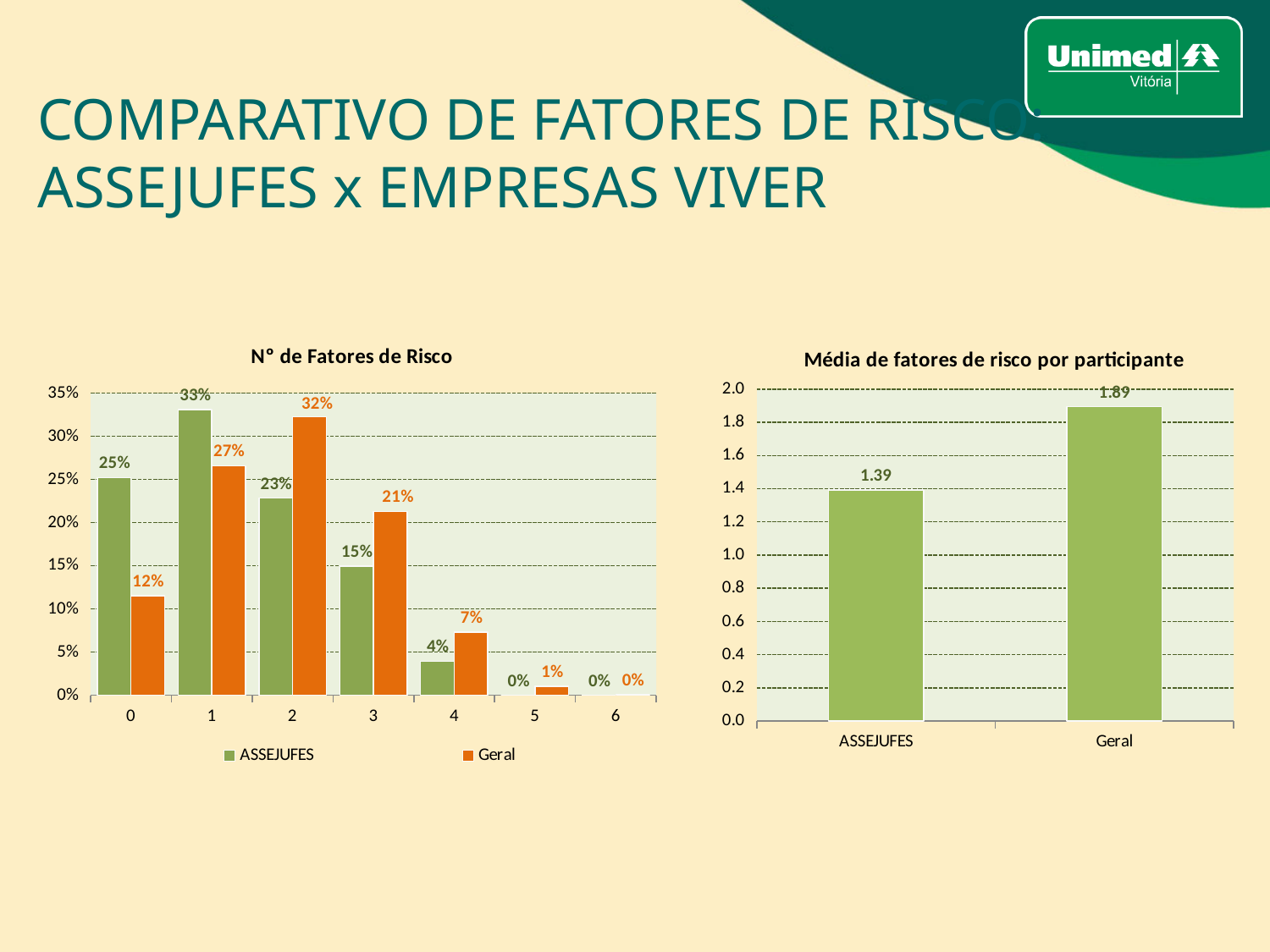
In the 'N° de Fatores de Risco' chart, what is the Geral value for category 0? 12% In the 'N° de Fatores de Risco' chart, what is the Geral value for category 2? 32% In the 'Média de fatores de risco por participante' chart, what is the difference between Geral and ASSEJUFES? 0.50 In the 'N° de Fatores de Risco' chart, how many series does the legend list? 2 In the 'N° de Fatores de Risco' chart, what colour are the Geral bars? Orange In the 'N° de Fatores de Risco' chart, how many categories are shown on the x axis? 7 What kind of chart is 'Média de fatores de risco por participante'? Bar chart In the 'N° de Fatores de Risco' chart, which is larger for category 3: ASSEJUFES or Geral? Geral In the 'Média de fatores de risco por participante' chart, what is the value for Geral? 1.89 In the 'N° de Fatores de Risco' chart, what is the difference between the ASSEJUFES and Geral values for category 0? 13% In the 'N° de Fatores de Risco' chart, what is the ASSEJUFES value for category 1? 33% In the 'N° de Fatores de Risco' chart, which category has the highest ASSEJUFES value? 1